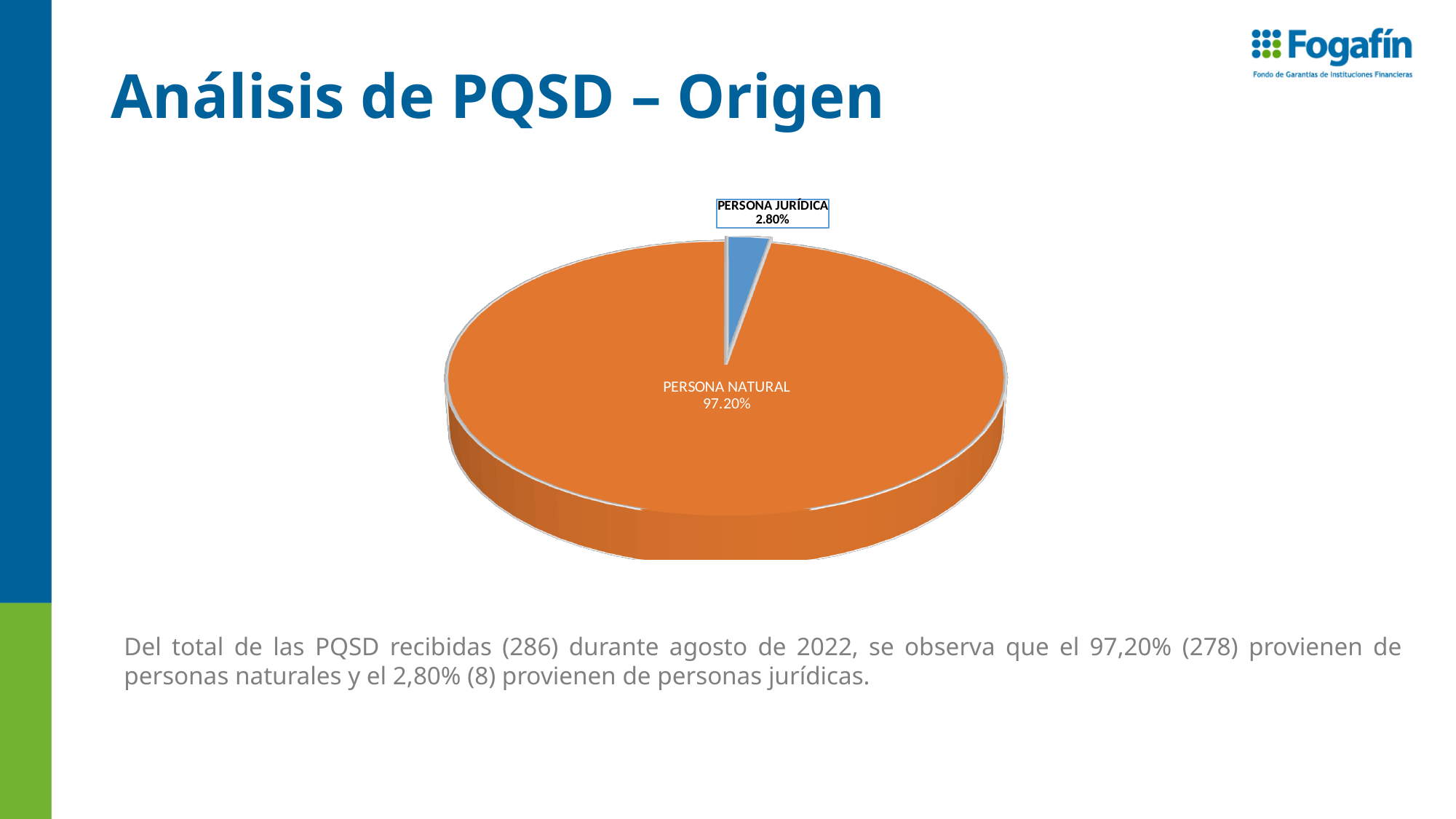
What share of the pie does PERSONA NATURAL represent? 97.20% Which slice is larger, PERSONA NATURAL or PERSONA JURÍDICA? PERSONA NATURAL What share of the pie does PERSONA JURÍDICA represent? 2.80% What colour is the PERSONA JURÍDICA slice? Blue Which category has the smallest slice of the pie? PERSONA JURÍDICA How many slices does the pie chart have? 2 What kind of chart is shown on the slide? Pie chart Which category has the largest slice of the pie? PERSONA NATURAL What is the difference in percentage points between the PERSONA NATURAL and PERSONA JURÍDICA slices? 94.40% What colour is the PERSONA NATURAL slice? Orange